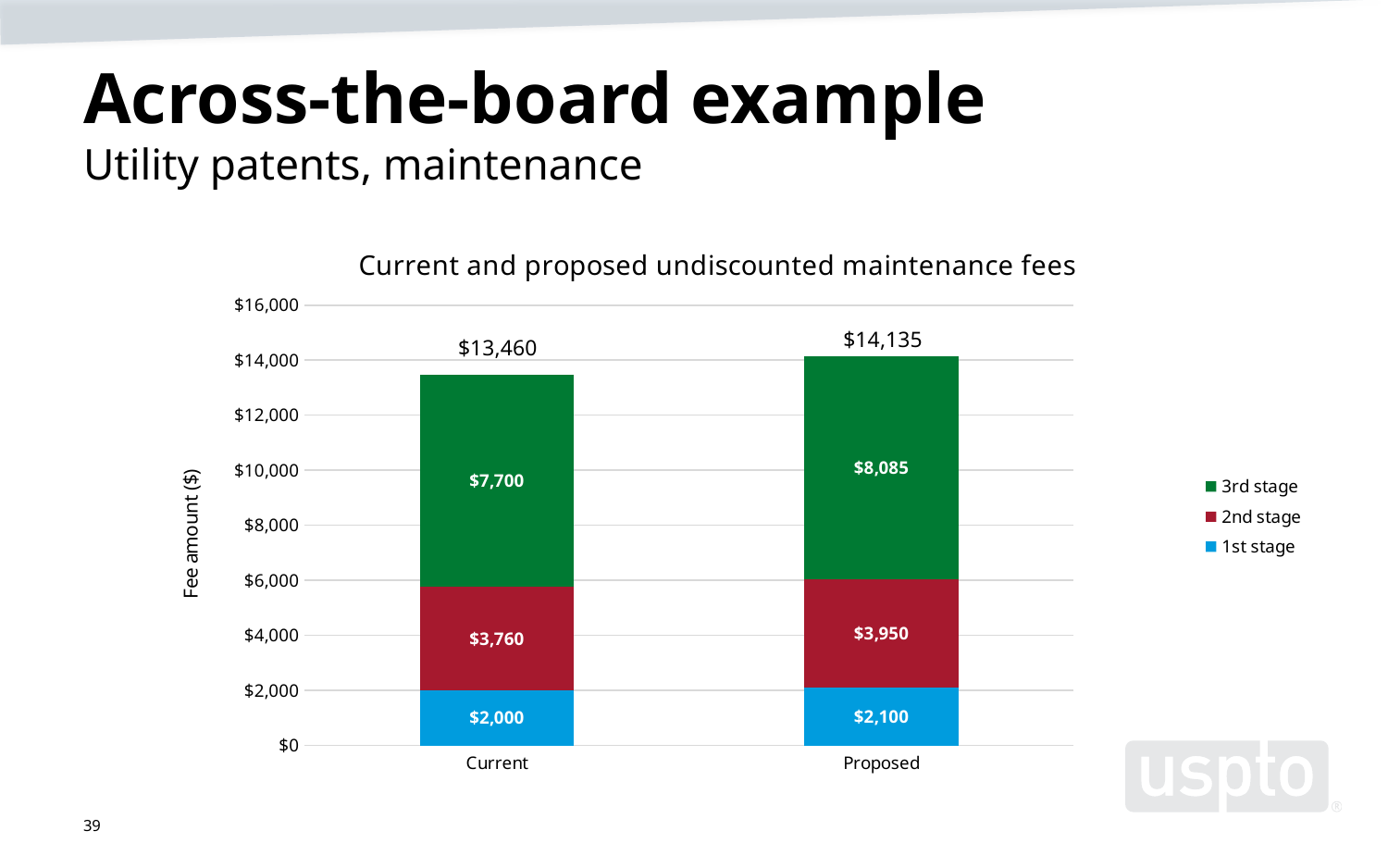
What is the 2nd stage fee for the Proposed category? $3,950 How many categories are shown on the x axis? 2 What is the 1st stage fee for the Current category? $2,000 What is the 3rd stage fee for the Current category? $7,700 What is the total of the Current stacked bar? $13,460 What is the difference between the Proposed and Current 3rd stage fees? $385 What is the total of the Proposed stacked bar? $14,135 Which stage has the lowest fee in the Proposed bar? 1st stage Which category has the higher total maintenance fee, Current or Proposed? Proposed What is the difference between the Proposed and Current total maintenance fees? $675 How many series does the legend list? 3 What kind of chart is shown on the slide? Stacked bar chart